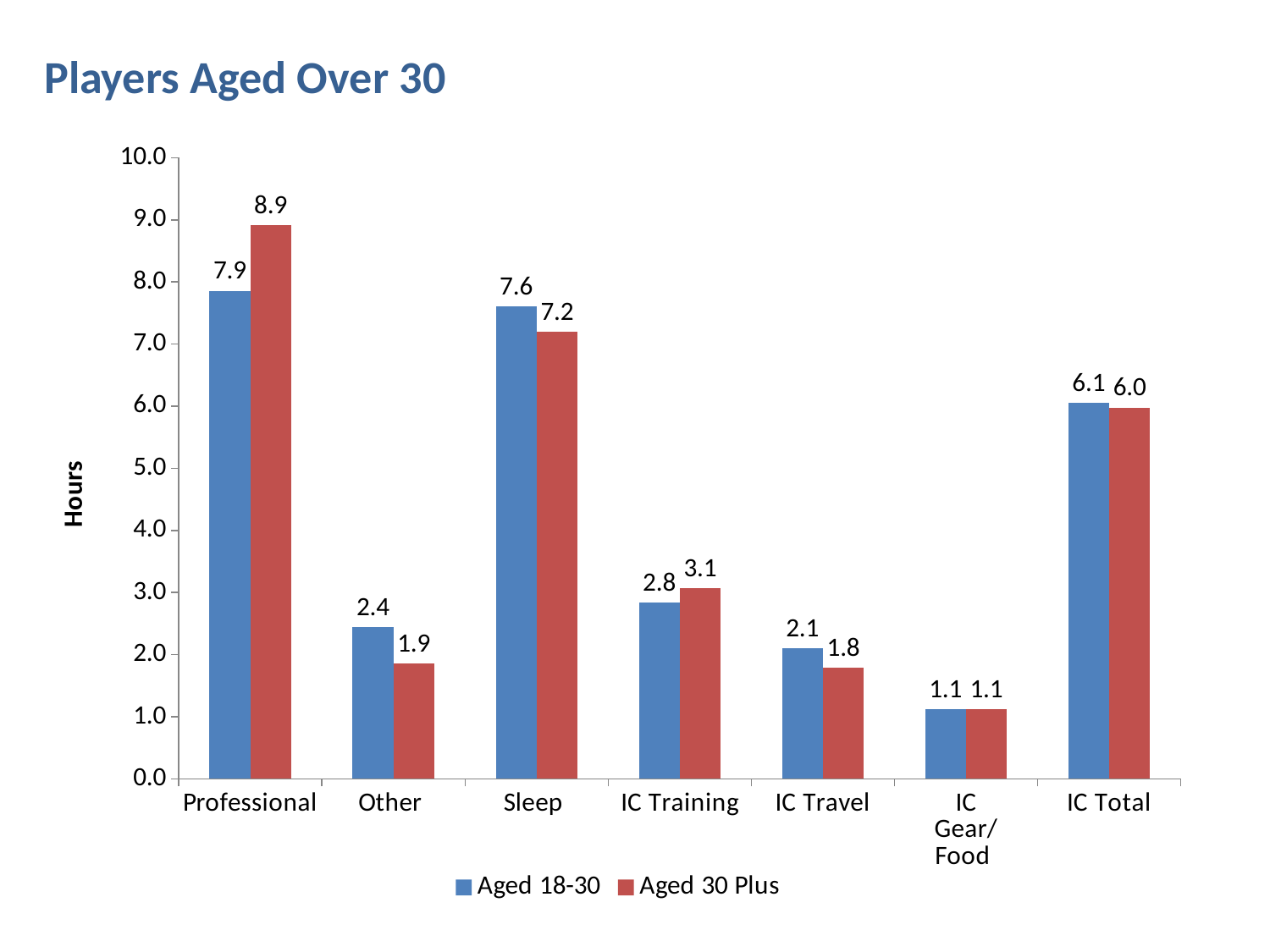
What is the value for Aged 18-30 in the Sleep category? 7.6 How many series does the legend list? 2 What is the difference between the Aged 18-30 and Aged 30 Plus values in the Other category? 0.5 What is the difference between the Aged 30 Plus and Aged 18-30 values in the Professional category? 1.0 What is the value for Aged 30 Plus in the IC Training category? 3.1 Is the Aged 18-30 value for IC Total greater or less than 5.0? greater Which category has the highest value for the Aged 30 Plus series? Professional Which category has the lowest value for the Aged 18-30 series? IC Gear/Food What kind of chart is shown on the slide? Bar chart How many categories are shown on the x axis? 7 What is the value for Aged 30 Plus in the Professional category? 8.9 In the Sleep category, which series has the larger value, Aged 18-30 or Aged 30 Plus? Aged 18-30